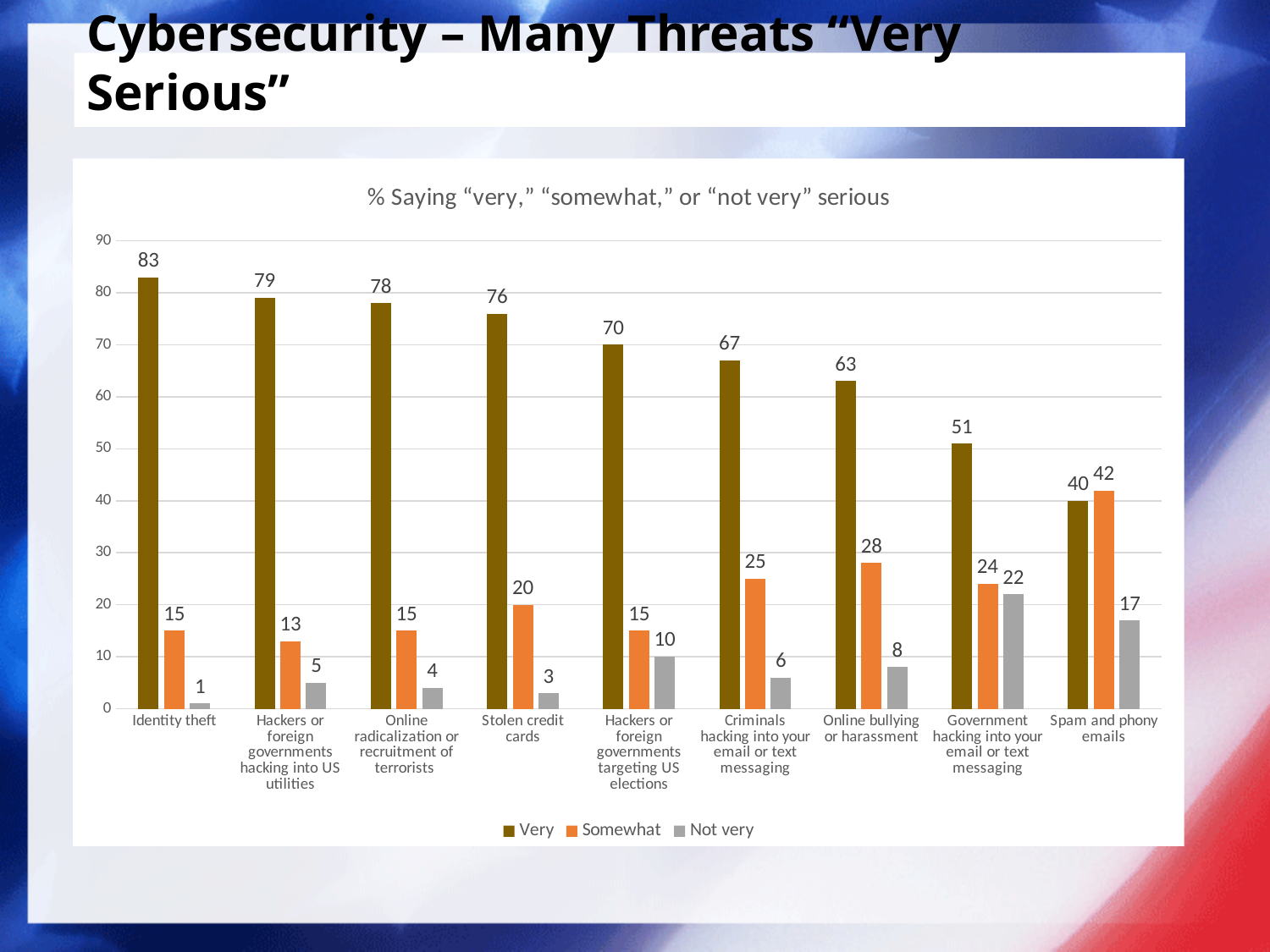
How many threat categories are shown on the x axis? 9 Which category has the lowest "Very" value? Spam and phony emails What is the "Somewhat" value for online bullying or harassment? 28 How many series does the legend list? 3 What is the "Not very" value for spam and phony emails? 17 Is the "Very" value for government hacking into your email or text messaging greater or less than 60? less What is the difference between the "Very" values for identity theft and stolen credit cards? 7 Do the "Very" values rise or fall from left to right across the categories? Fall Which category has the highest "Very" value? Identity theft What percentage say identity theft is a "very" serious threat? 83 Which is larger for spam and phony emails: the "Very" value or the "Somewhat" value? Somewhat What kind of chart is shown on the slide? Bar chart